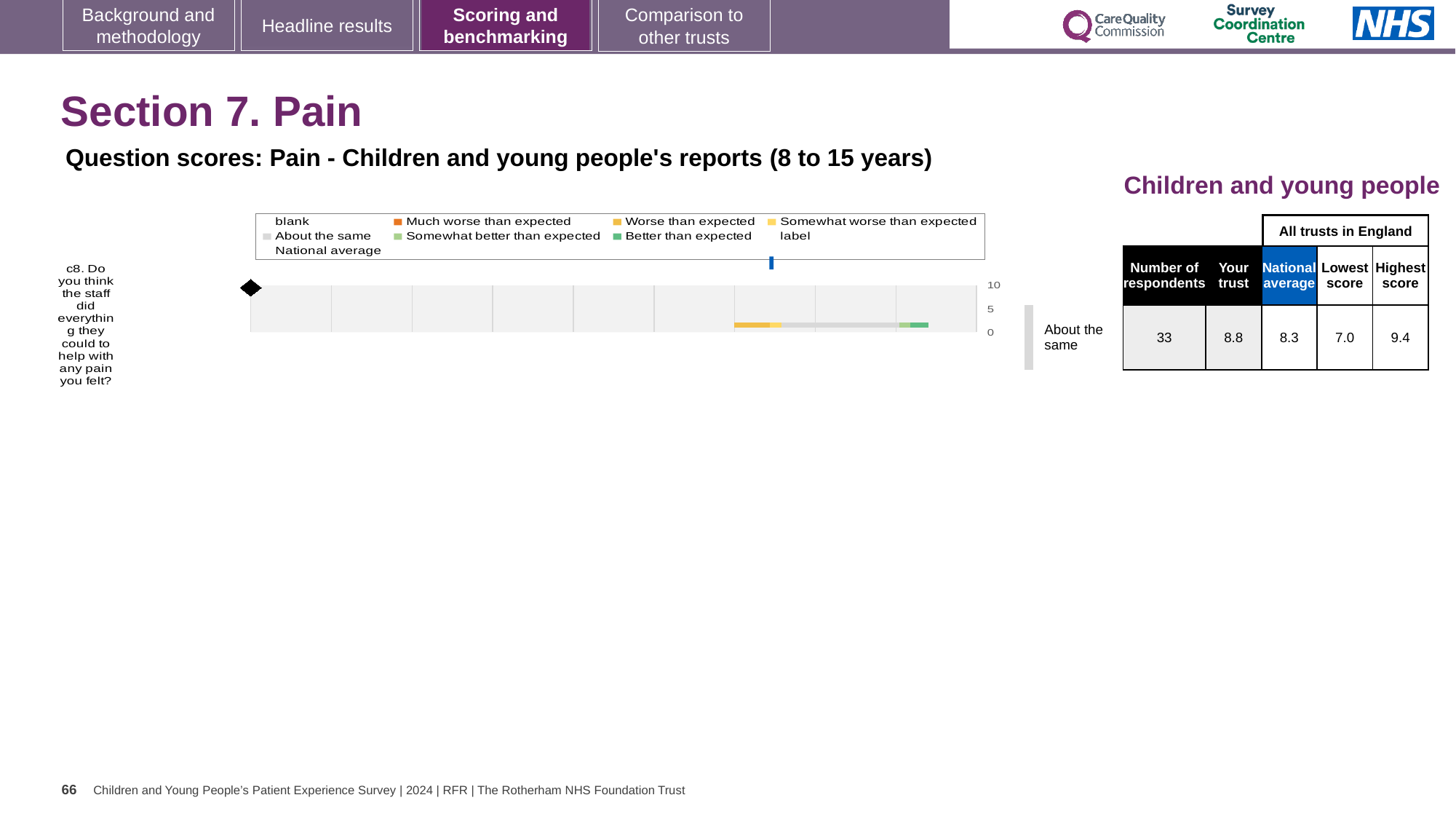
What is the national average score for question c8? 8.3 What is the difference between the 'Your trust' score and the national average for question c8? 0.5 What is the lowest score among all trusts in England for question c8? 7.0 How many respondents answered question c8? 33 How is the trust's result for question c8 categorised relative to expectation? About the same What kind of chart is shown on the slide? bar chart How many survey questions are plotted in the chart? 1 What is the highest value shown on the chart's axis? 10 Which is larger for question c8, the 'Your trust' score or the national average? Your trust What colour does the legend use for 'Better than expected'? green What is the highest score among all trusts in England for question c8? 9.4 What is the 'Your trust' score for question c8 in the table? 8.8